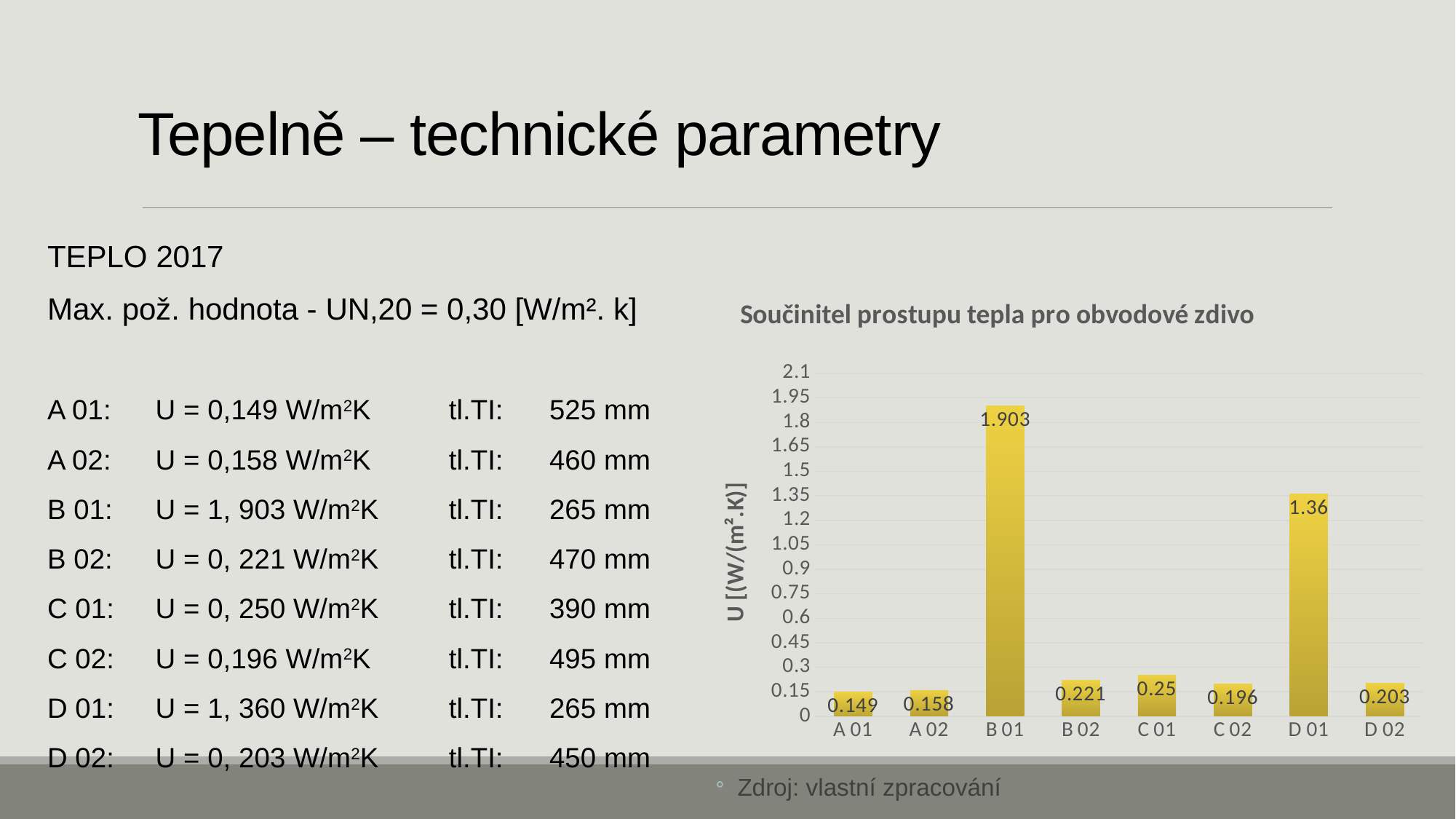
Is the value for D 01 greater or less than 1.2? greater What is the value for D 01 in the chart? 1.36 What is the value for C 02 in the chart? 0.196 What kind of chart is shown on the slide? bar chart What is the difference between the values for C 01 and A 02? 0.092 What is the difference between the values for B 01 and D 01? 0.543 What is the value for B 01 in the chart? 1.903 Which category has the lowest value in the chart? A 01 Which is larger, the value for B 02 or the value for D 02? B 02 What is the title of the chart? Součinitel prostupu tepla pro obvodové zdivo How many categories are shown in the chart? 8 Which category has the highest value in the chart? B 01